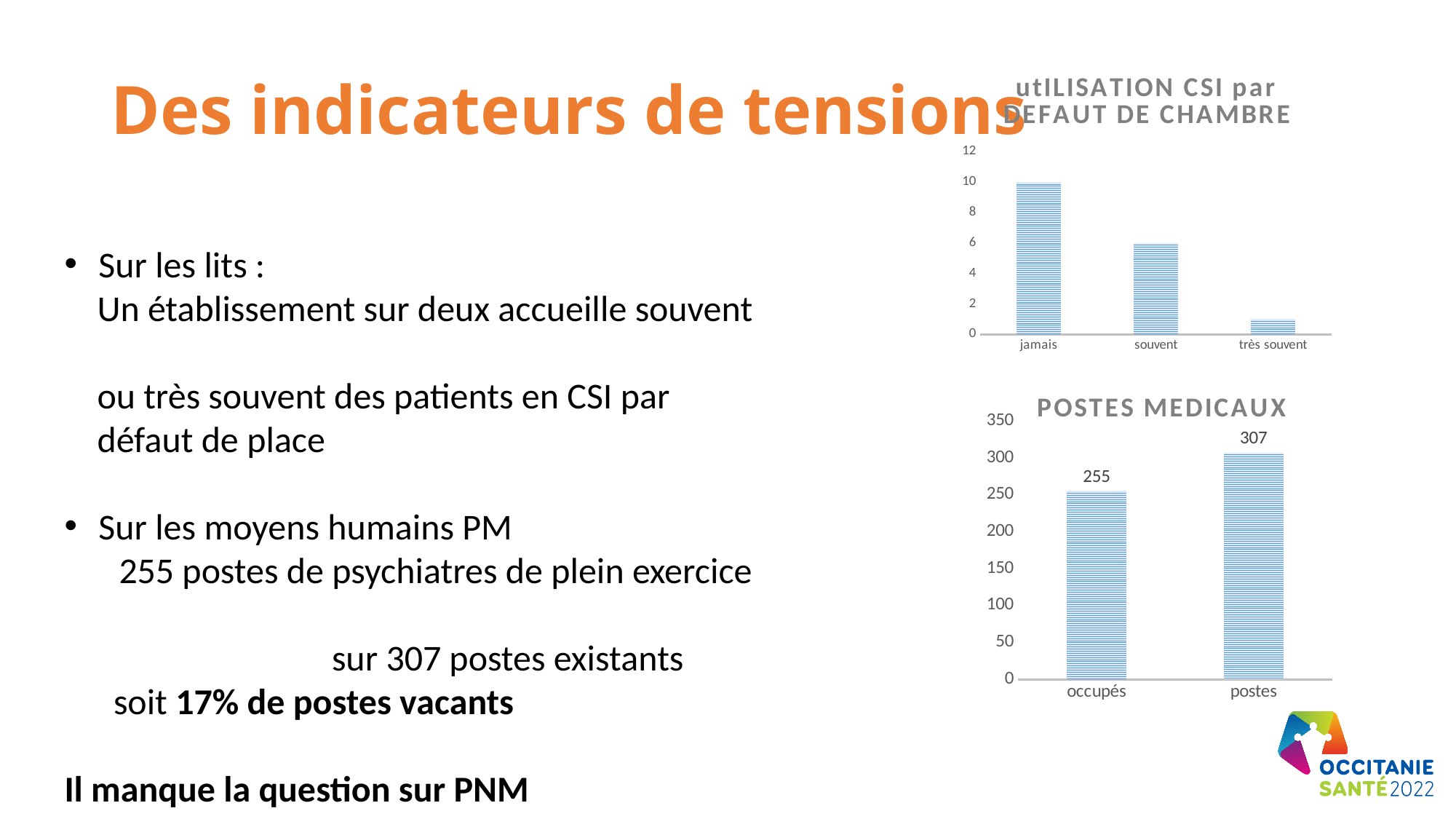
In the utILISATION CSI par DEFAUT DE CHAMBRE chart, how many categories are shown on the x axis? 3 In the utILISATION CSI par DEFAUT DE CHAMBRE chart, is the value for très souvent greater or less than 2? less In the POSTES MEDICAUX chart, what is the value for postes? 307 What kind of chart is the POSTES MEDICAUX chart? bar chart In the POSTES MEDICAUX chart, which category has the higher value, occupés or postes? postes In the POSTES MEDICAUX chart, what is the value for occupés? 255 In the utILISATION CSI par DEFAUT DE CHAMBRE chart, which category has the lowest value? très souvent In the utILISATION CSI par DEFAUT DE CHAMBRE chart, which category has the highest value? jamais In the POSTES MEDICAUX chart, what is the difference between postes and occupés? 52 In the utILISATION CSI par DEFAUT DE CHAMBRE chart, is the value for jamais greater or less than 8? greater In the POSTES MEDICAUX chart, how many categories are shown? 2 In the utILISATION CSI par DEFAUT DE CHAMBRE chart, do the values rise or fall from jamais to très souvent? fall